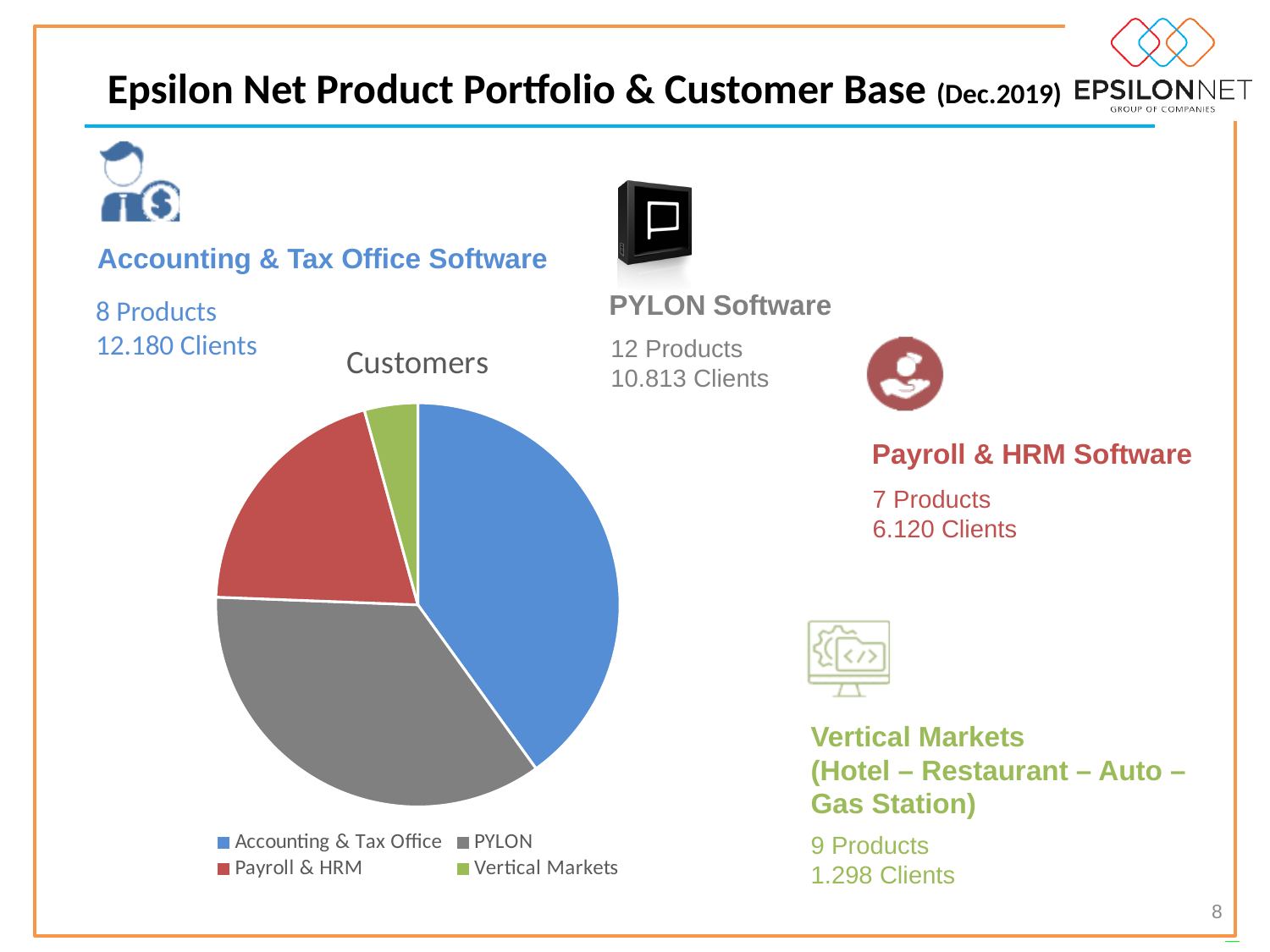
What colour is the PYLON slice in the Customers pie chart? gray How many slices does the Customers pie chart have? 4 According to the slide, how many clients does the Payroll & HRM segment have? 6.120 Clients In the Customers pie chart, which slice is larger: PYLON or Payroll & HRM? PYLON Which category has the largest slice in the Customers pie chart? Accounting & Tax Office What is the title of the pie chart? Customers According to the slide, how many clients does the Vertical Markets segment have? 1.298 Clients According to the slide, how many clients does the Accounting & Tax Office segment have? 12.180 Clients What kind of chart is shown on the slide? pie chart Which category has the smallest slice in the Customers pie chart? Vertical Markets In the Customers pie chart, which slice is larger: Payroll & HRM or Vertical Markets? Payroll & HRM How many entries does the legend of the Customers pie chart list? 4